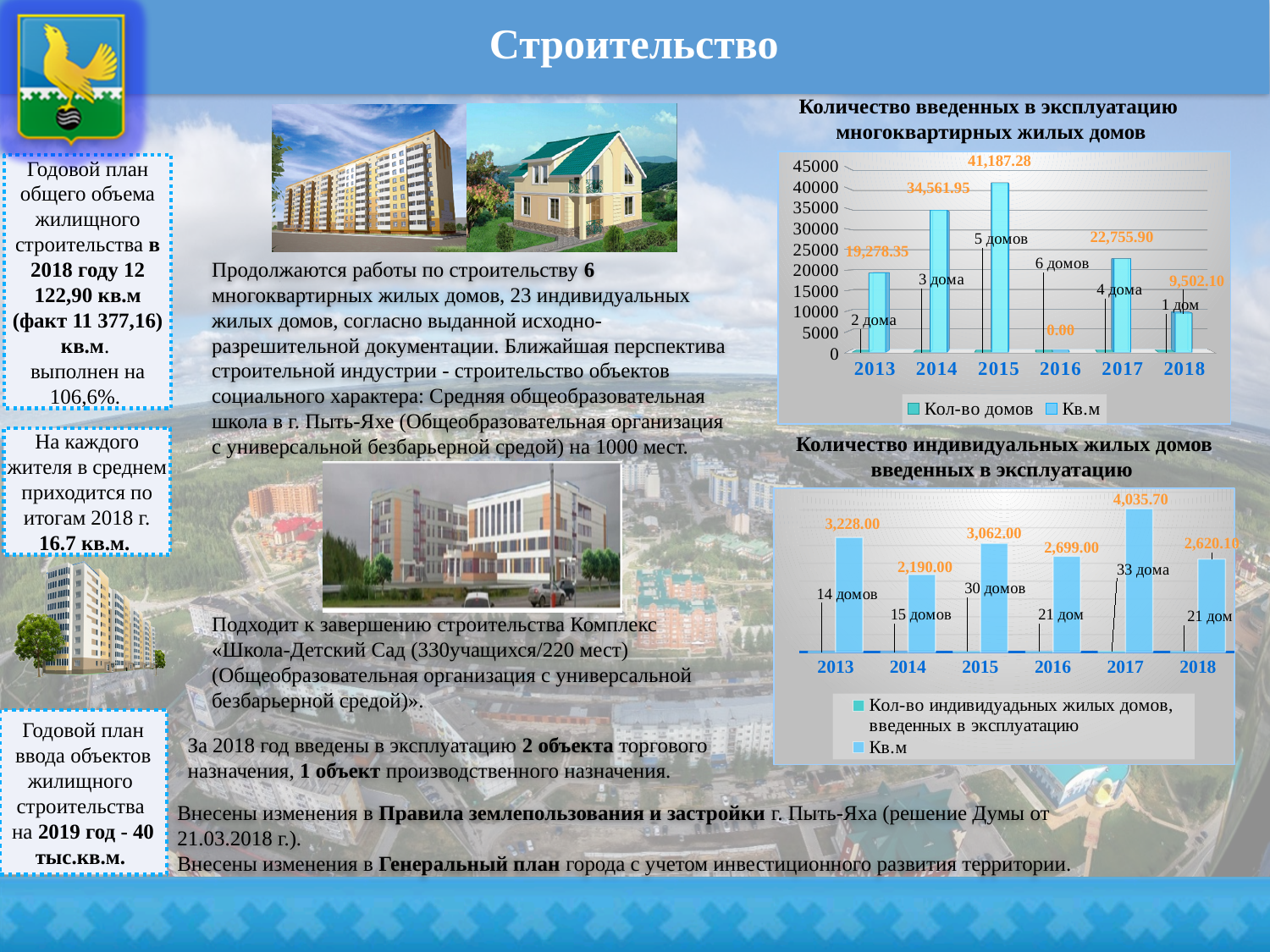
In the chart 'Количество индивидуальных жилых домов введенных в эксплуатацию', what is the Кв.м value for 2017? 4,035.70 In the chart 'Количество введенных в эксплуатацию многоквартирных жилых домов', which year has the highest Кв.м value? 2015 In the chart 'Количество индивидуальных жилых домов введенных в эксплуатацию', is the Кв.м value larger for 2013 or for 2016? 2013 What type of chart is 'Количество индивидуальных жилых домов введенных в эксплуатацию'? Bar chart In the chart 'Количество введенных в эксплуатацию многоквартирных жилых домов', how many houses (Кол-во домов) are labelled for 2016? 6 домов In the chart 'Количество индивидуальных жилых домов введенных в эксплуатацию', how many individual houses are labelled for 2015? 30 домов In the chart 'Количество введенных в эксплуатацию многоквартирных жилых домов', what is the Кв.м value for 2015? 41,187.28 In the chart 'Количество введенных в эксплуатацию многоквартирных жилых домов', which year has the lowest Кв.м value? 2016 In the chart 'Количество введенных в эксплуатацию многоквартирных жилых домов', what is the difference between the Кв.м values for 2014 and 2013? 15,283.60 In the chart 'Количество индивидуальных жилых домов введенных в эксплуатацию', which year has the lowest Кв.м value? 2014 In the chart 'Количество введенных в эксплуатацию многоквартирных жилых домов', how many series does the legend list? 2 In the chart 'Количество введенных в эксплуатацию многоквартирных жилых домов', how many years are shown on the x axis? 6